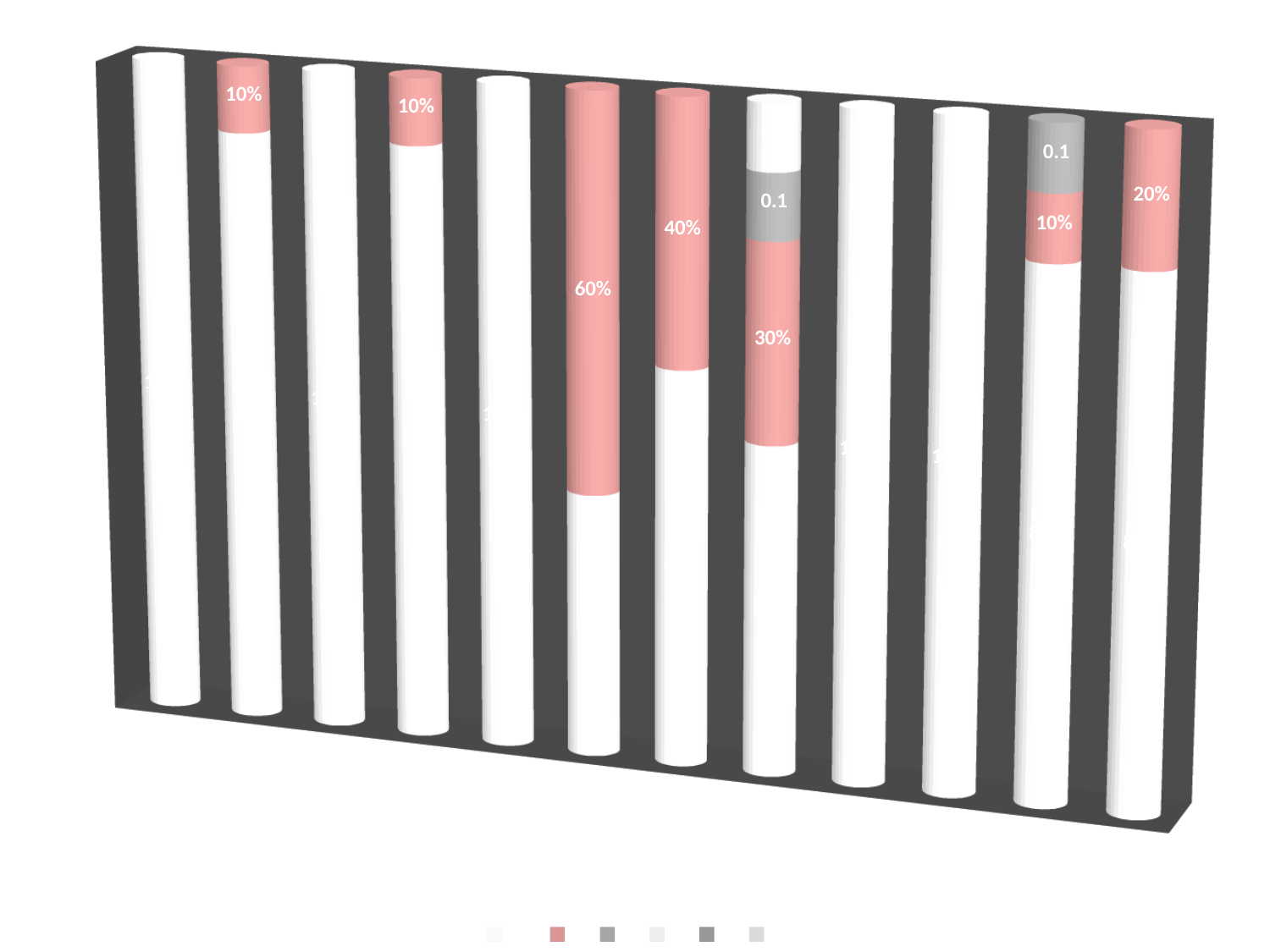
What value is labelled on the grey segment of the eighth bar from the left? 0.1 What kind of chart is shown on the slide? bar chart What is the difference between the pink segment labels of the sixth and seventh bars from the left? 20% What value is labelled on the pink segment of the second bar from the left? 10% How many bars are plotted in the chart? 12 What value is labelled on the pink segment of the seventh bar from the left? 40% What value is labelled on the pink segment of the rightmost bar? 20% What value is labelled on the pink segment of the eighth bar from the left? 30% Which is larger: the pink segment of the seventh bar from the left or the pink segment of the eighth bar from the left? the seventh bar (40%) What value is labelled on the pink segment of the sixth bar from the left? 60% How many series does the legend list? 6 Which bar has the largest labelled pink segment? the sixth bar from the left (60%)